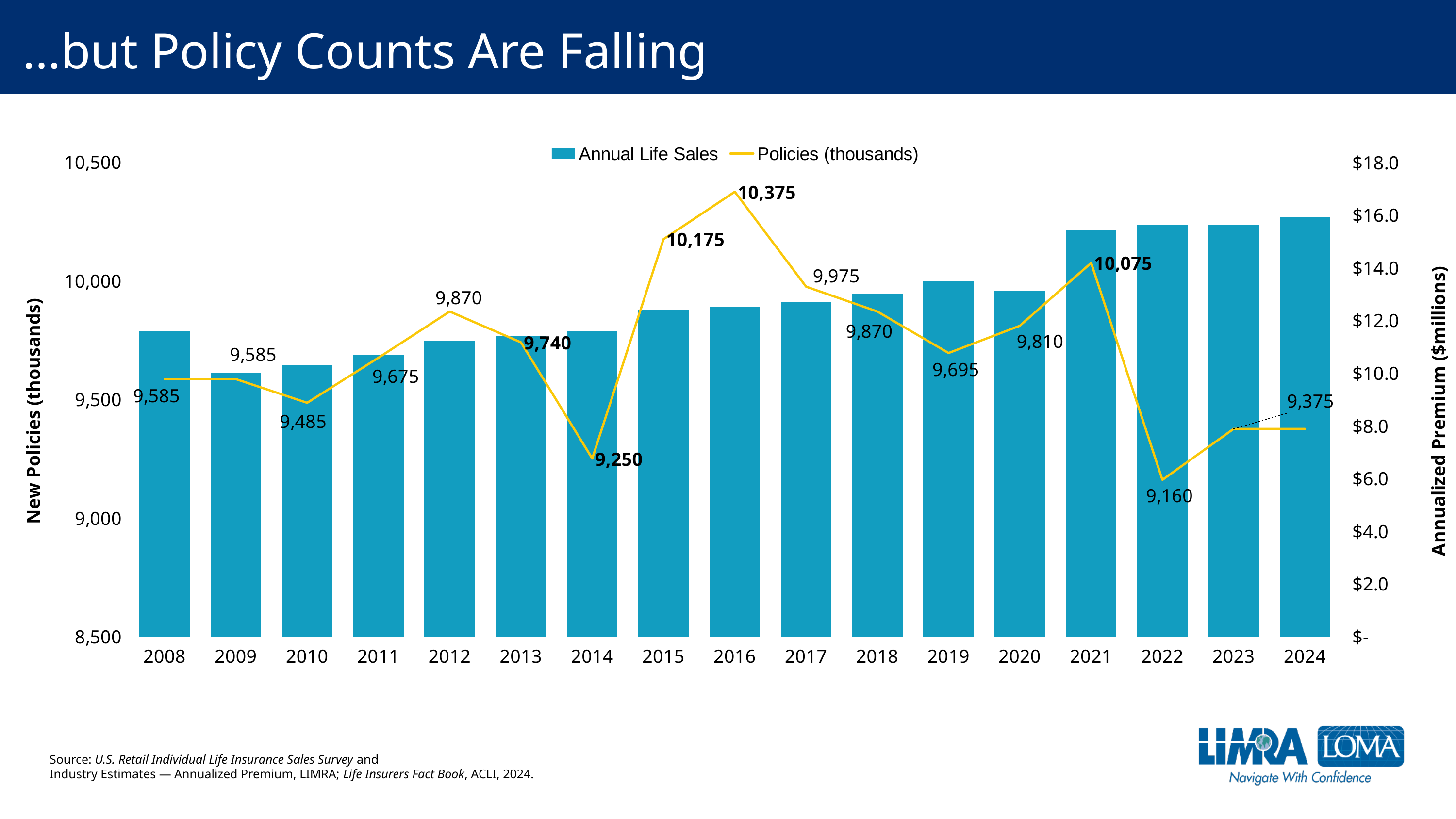
Is the Annual Life Sales bar for 2008 greater or less than $10.0? greater By how much did Policies (thousands) increase from 2014 to 2015? 925 How many years are shown on the x axis? 17 In which year is the Policies (thousands) line at its highest? 2016 What is the value of Policies (thousands) for 2014? 9,250 Is the Annual Life Sales bar for 2021 greater or less than $14.0? greater How many series does the legend list? 2 Which year has the larger Policies (thousands) value, 2015 or 2021? 2015 What is the difference between the Policies (thousands) values for 2016 and 2022? 1,215 In which year is the Policies (thousands) line at its lowest? 2022 What is the value of Policies (thousands) for 2016? 10,375 What kind of chart is shown on the slide? Combination bar and line chart